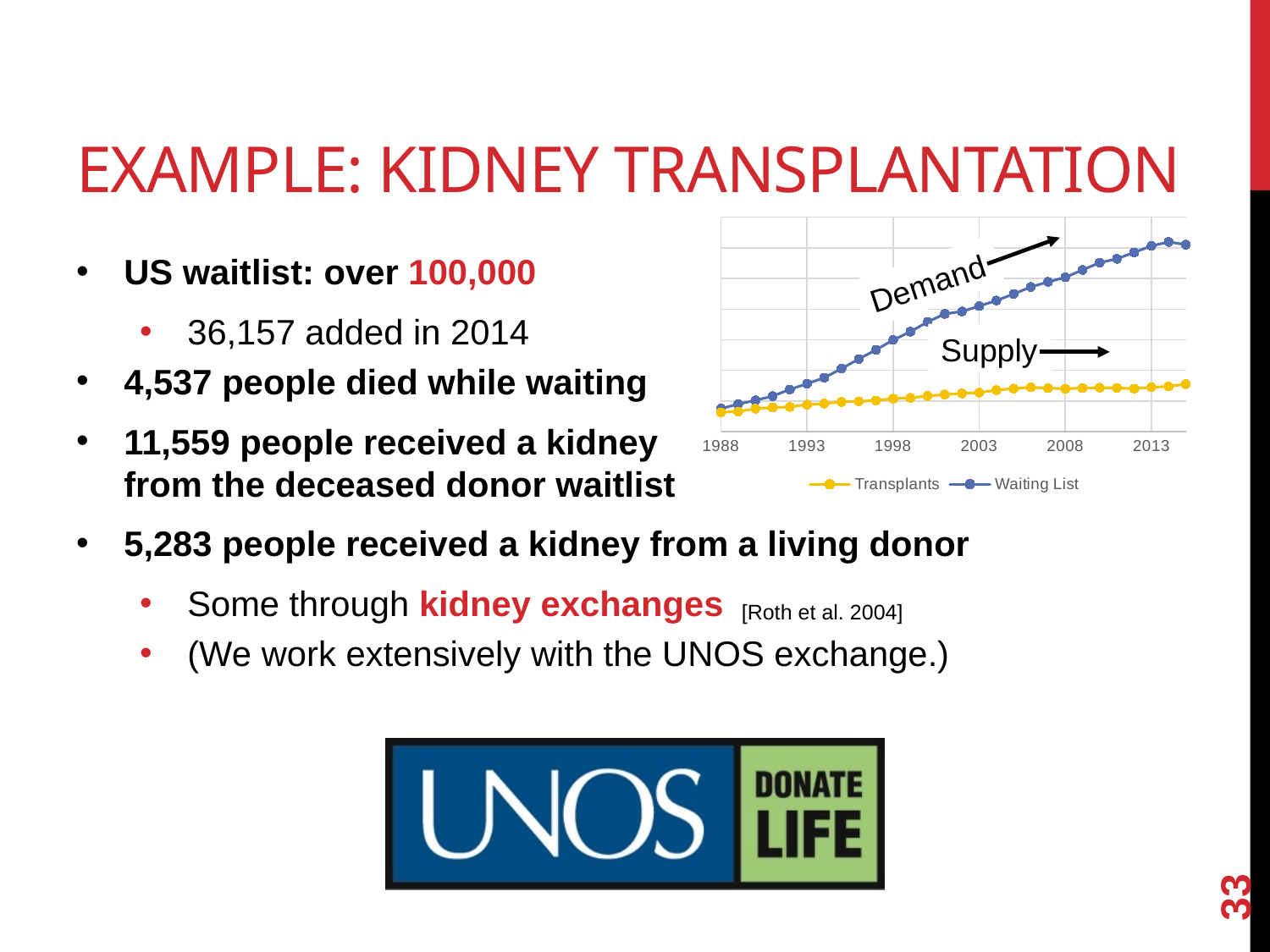
What is the first year labelled on the chart's x axis? 1988 What are the two series named in the chart's legend? Transplants and Waiting List How many series does the chart's legend list? 2 Which series grows faster over the period shown, Transplants or Waiting List? Waiting List What kind of chart is shown on the slide? line chart Does the Waiting List series rise or fall from 1988 to 2013? rise Which series is higher at the right end of the chart, Transplants or Waiting List? Waiting List Which series is annotated as "Supply" on the chart? Transplants How many year labels are shown on the chart's x axis? 6 Which series is annotated as "Demand" on the chart? Waiting List Does the Transplants series rise or fall over the years shown? rise What is the last year labelled on the chart's x axis? 2013